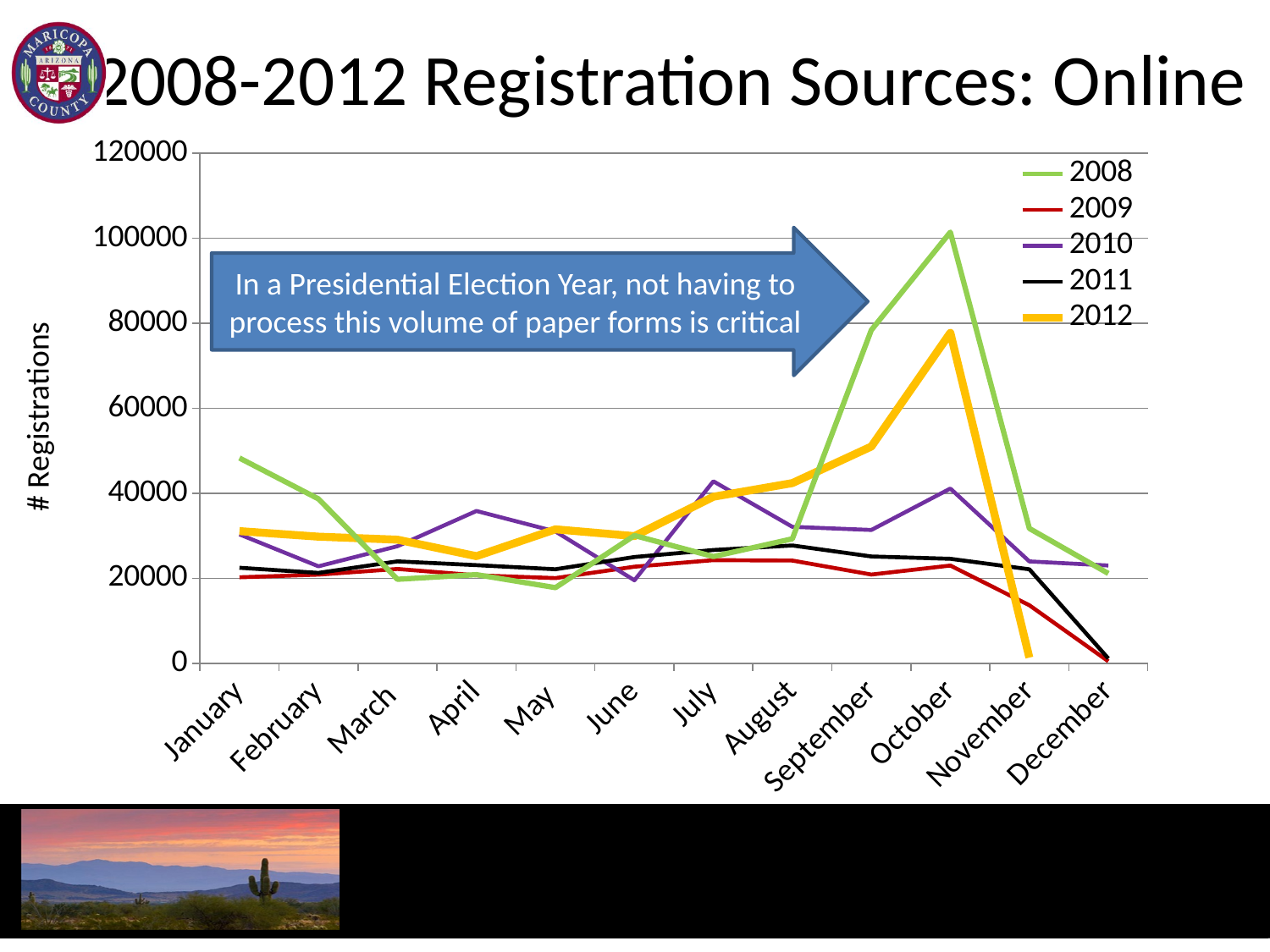
Is the value for 2012 in November greater or less than 20000? less Does the 2008 line rise or fall from October to December? fall Is the value for 2008 in January greater or less than 40000? greater Which is larger in September, the value for 2012 or the value for 2011? 2012 What is the label on the y axis? # Registrations How many series does the legend list? 5 Is the value for 2008 in October greater or less than 80000? greater What kind of chart is shown on the slide? line chart How many months are shown along the x axis? 12 In which month does the 2012 line reach its highest value? October Which year's line reaches the highest value in October? 2008 Which is larger in October, the value for 2008 or the value for 2012? 2008